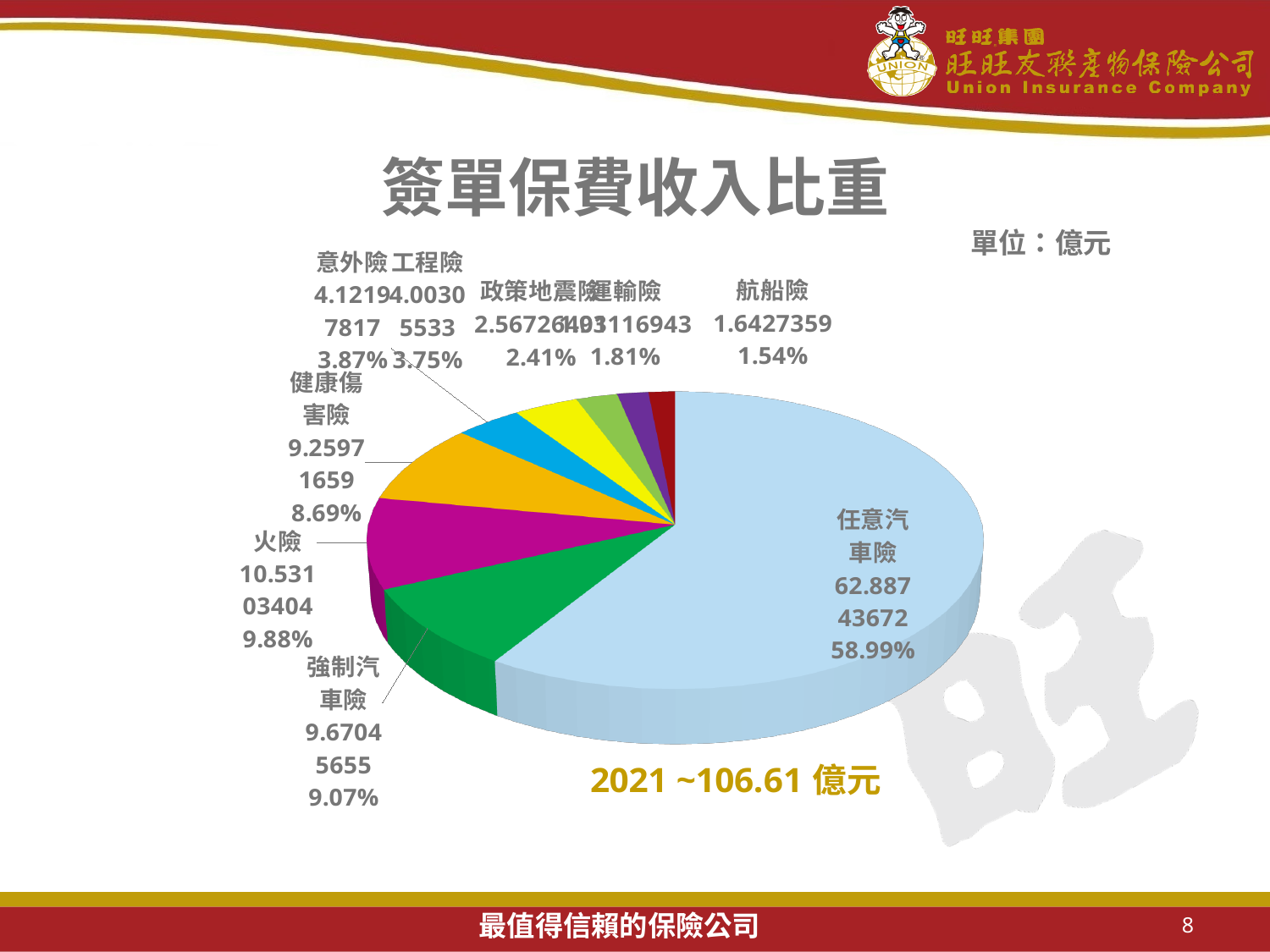
What kind of chart is shown on the slide? pie chart What percentage share is shown for 火險? 9.88% What is the difference in percentage share between 任意汽車險 and 火險? 49.11% What unit is stated for the values on the slide? 億元 What percentage share is shown for 任意汽車險? 58.99% What percentage share is shown for 航船險? 1.54% Which has the larger share, 火險 or 強制汽車險? 火險 How many categories are shown in the pie chart? 9 Which category has the largest share of the pie? 任意汽車險 Which category has the smallest share of the pie? 航船險 Which has the larger share, 意外險 or 工程險? 意外險